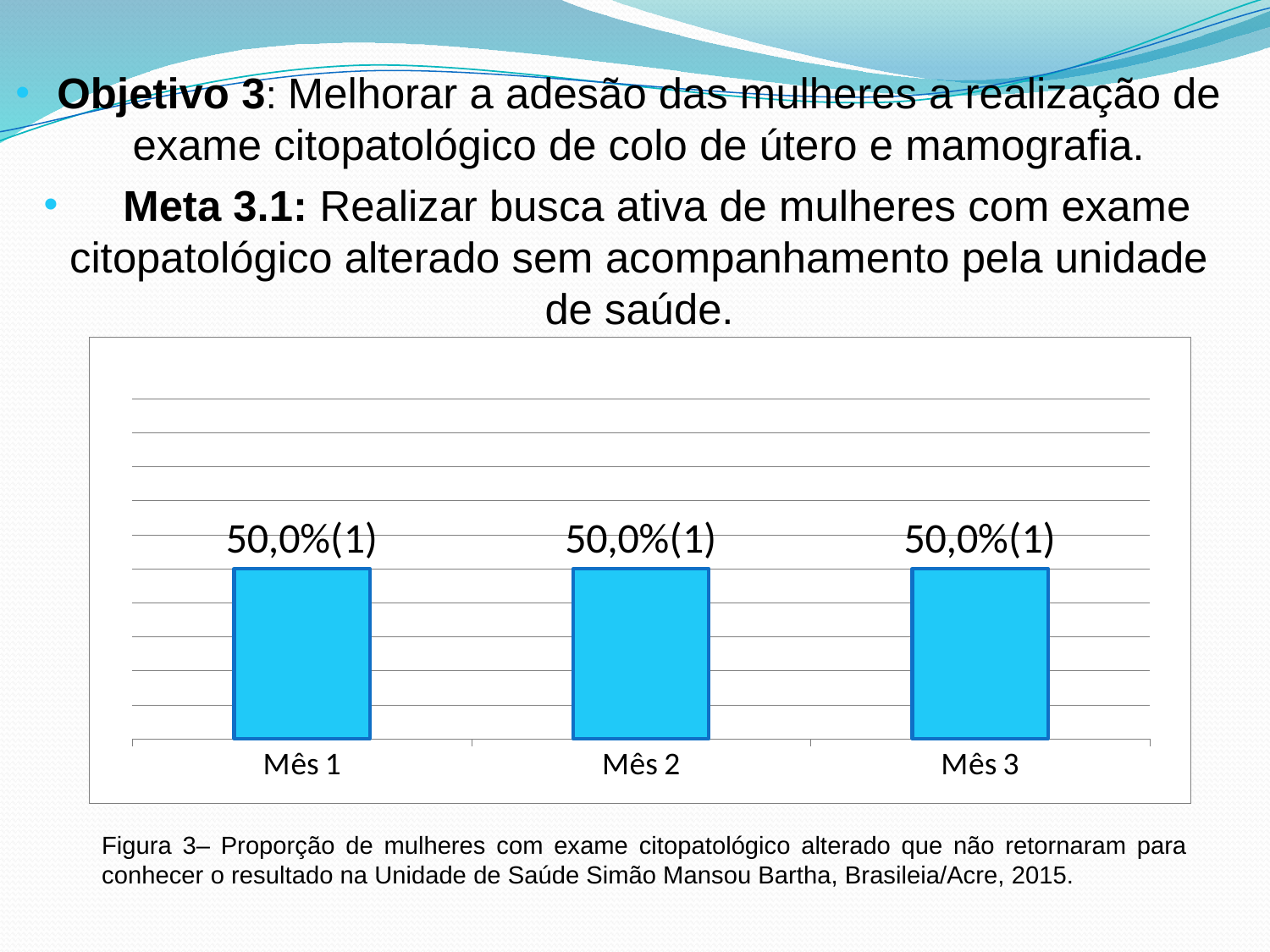
What is the value shown for Mês 1? 50,0%(1) Is the value for Mês 2 larger than, smaller than, or equal to the value for Mês 1? Equal What is the difference between the values for Mês 1 and Mês 3? 0 What is the value shown for Mês 3? 50,0%(1) Do the values rise, fall or stay the same from Mês 1 to Mês 3? Stay the same What colour are the bars in the chart? Blue What kind of chart is shown on the slide? Bar chart What is the label of the first category on the x axis? Mês 1 How many categories (months) are plotted on the chart? 3 What is the value shown for Mês 2? 50,0%(1)